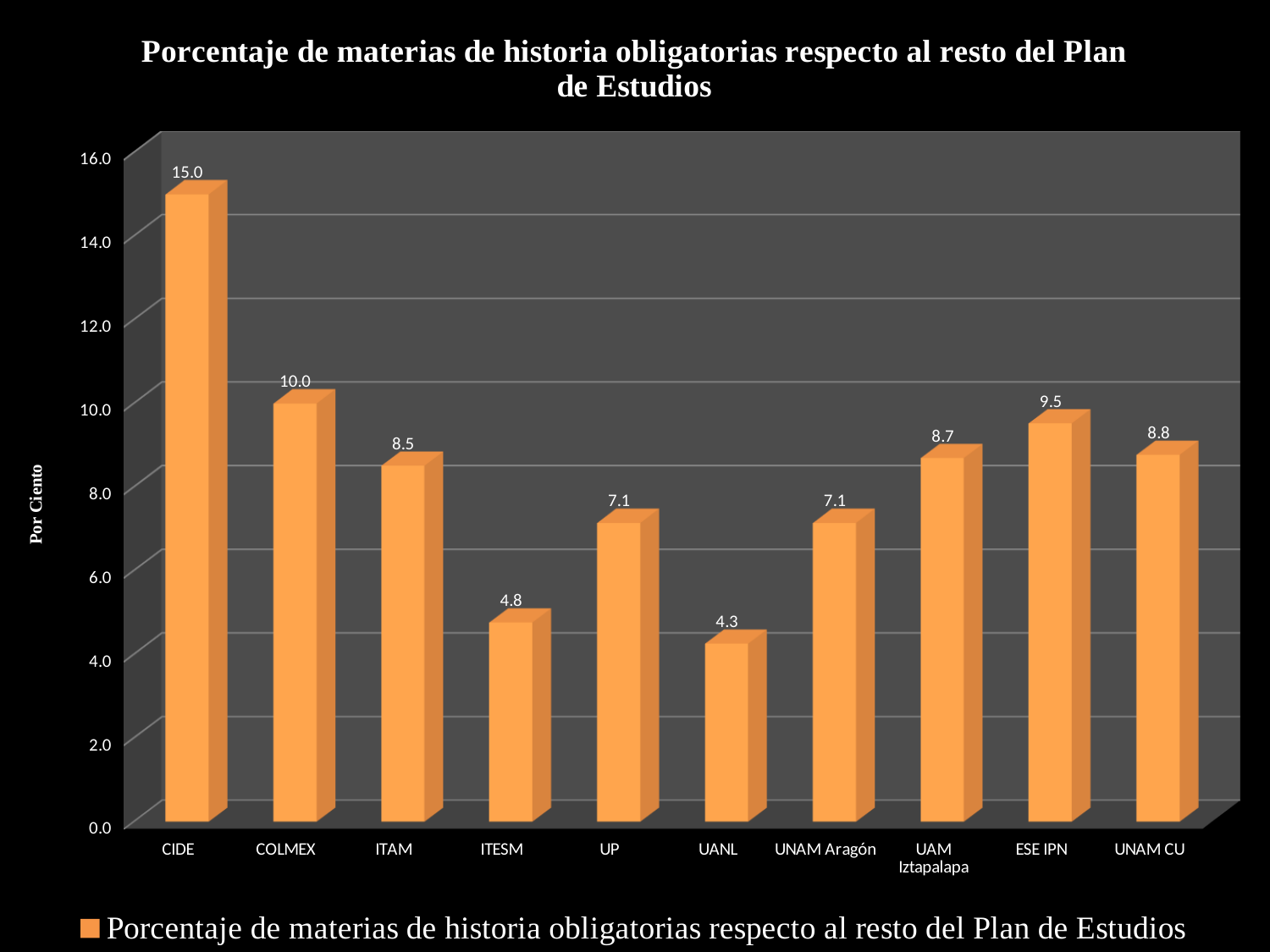
Is the value for UP greater or less than 8.0? less What is the value for ESE IPN? 9.5 What kind of chart is shown on the slide? bar chart What is the difference between the values for ITESM and UANL? 0.5 What is the label of the y axis? Por Ciento How many categories are shown on the x axis? 10 Which category has the highest value? CIDE What is the value for UAM Iztapalapa? 8.7 Which is larger, the value for ITAM or the value for UNAM CU? UNAM CU Which category has the lowest value? UANL What is the value for CIDE? 15.0 What is the difference between the values for CIDE and COLMEX? 5.0